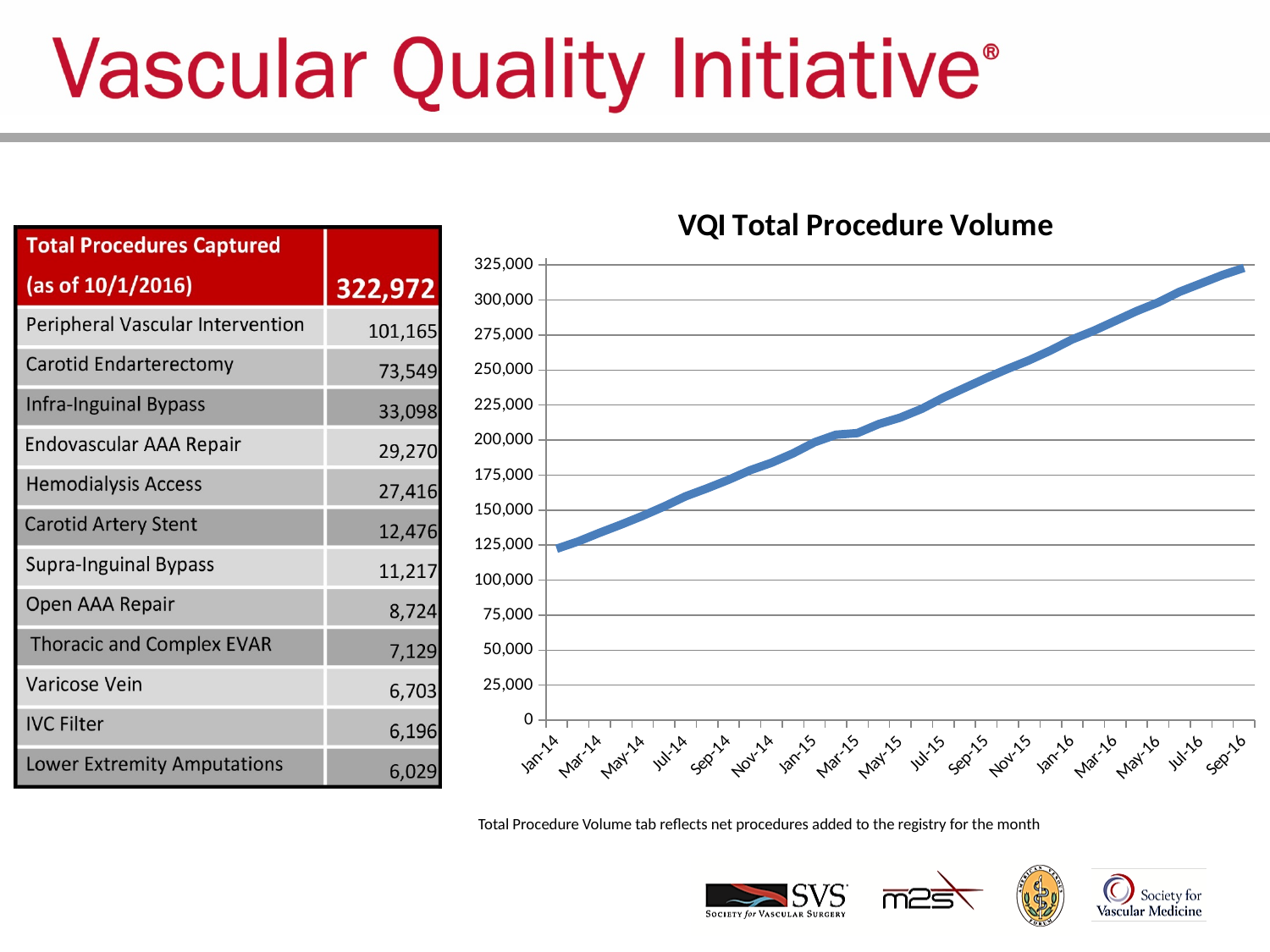
Which month has the lowest value in the VQI Total Procedure Volume chart? Jan-14 What type of chart is shown on the slide? line chart Which is larger, the value for Sep-16 or the value for Jan-14? Sep-16 Do the values in the VQI Total Procedure Volume chart rise or fall from Jan-14 to Sep-16? rise Is the value for Jan-16 greater or less than 250,000? greater Is the value for Sep-16 greater or less than 300,000? greater What is the highest tick value shown on the y axis of the chart? 325,000 What is the title of the chart? VQI Total Procedure Volume Which month has the highest value in the VQI Total Procedure Volume chart? Sep-16 Is the value for Sep-14 greater or less than 150,000? greater